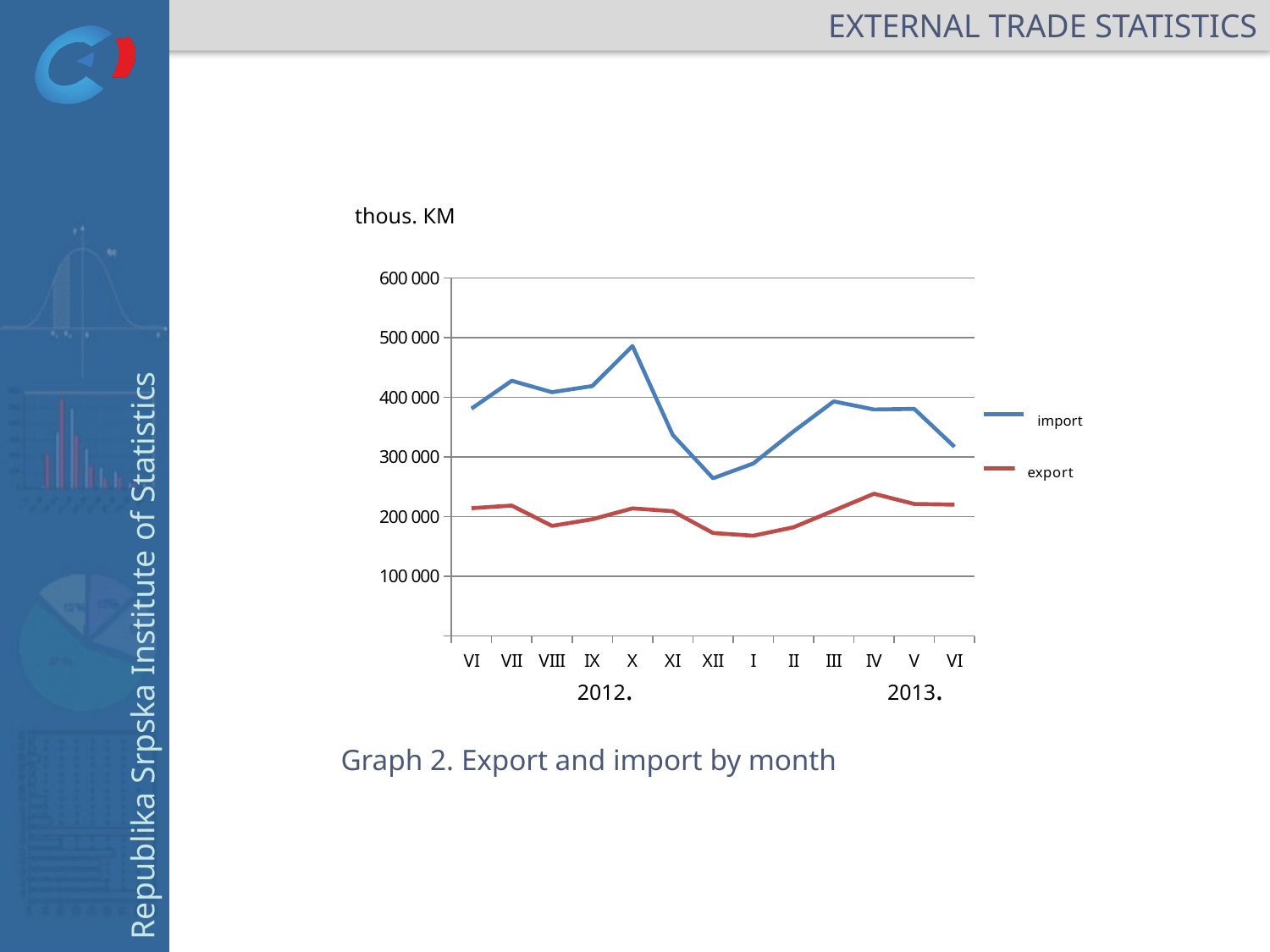
Which is larger in III 2013, import or export? import Is the import value for XII 2012 greater or less than 300 000? less Is the import value for X 2012 greater or less than 400 000? greater In which month does the export line reach its highest value? IV 2013 What unit is stated above the chart? thous. KM In which month does the import line reach its lowest value? XII 2012 How many monthly points are plotted along the x axis? 13 In which month does the import line reach its highest value? X 2012 What kind of chart is shown on the slide? line chart How many series does the legend list? 2 Is the export value for I 2013 greater or less than 200 000? less Does the import line rise or fall from X 2012 to XII 2012? fall